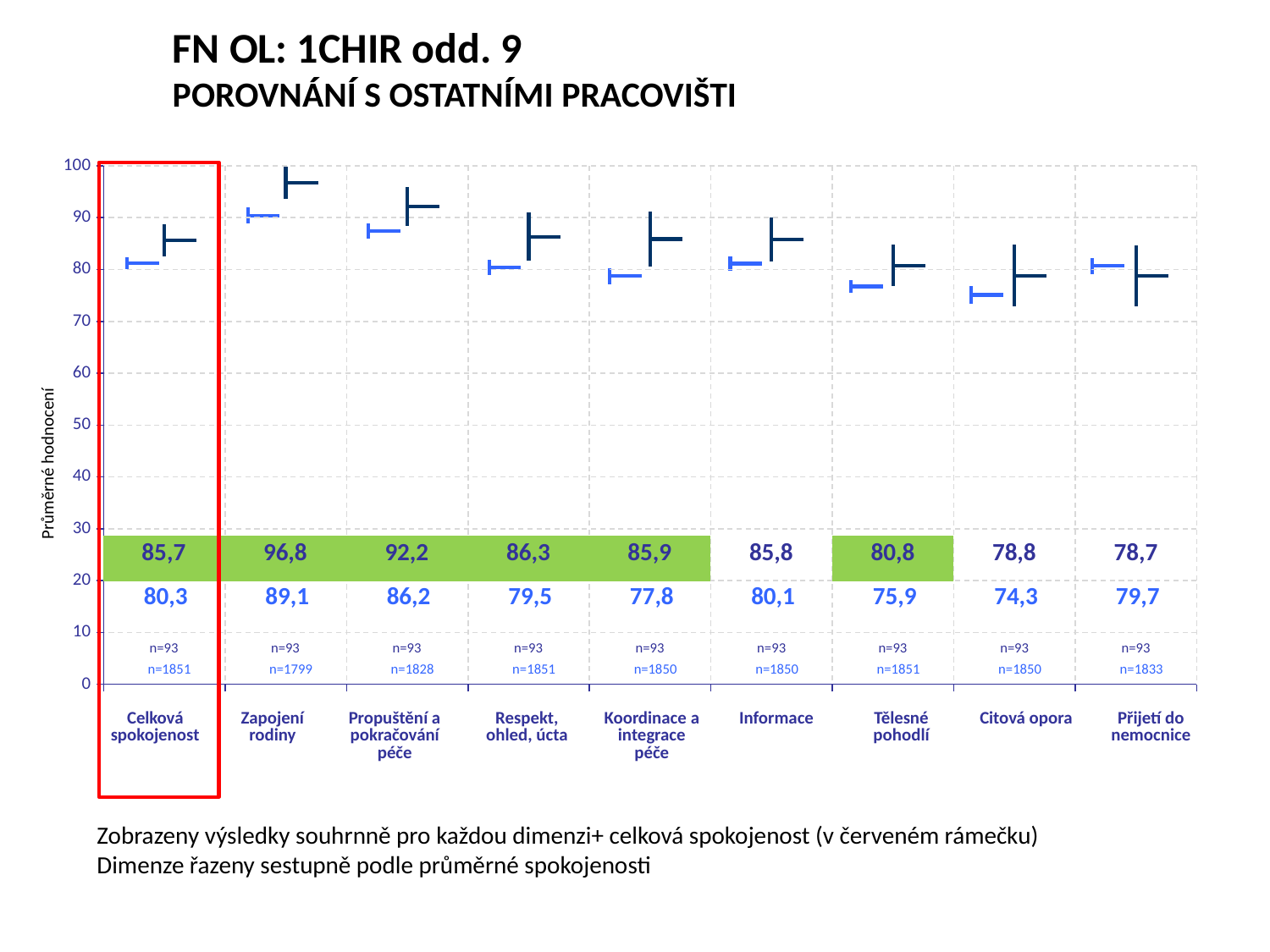
For Přijetí do nemocnice, which is larger: the dark blue value or the light blue value? the light blue value (79,7) What is the difference between the dark blue and light blue values for Zapojení rodiny? 7,7 Which category has the lowest dark blue (top row) value? Přijetí do nemocnice Which category has the highest dark blue (top row) value? Zapojení rodiny What is the dark blue (top row) value for Zapojení rodiny? 96,8 What is the light blue (bottom row) value for Informace? 80,1 What is the difference between the dark blue and light blue values for Celková spokojenost? 5,4 Which category is enclosed in the red frame? Celková spokojenost Which category has the lowest light blue (bottom row) value? Citová opora Is the dark blue marker for Citová opora greater or less than 80? less What is the dark blue (top row) value for Tělesné pohodlí? 80,8 How many categories are shown on the x axis? 9